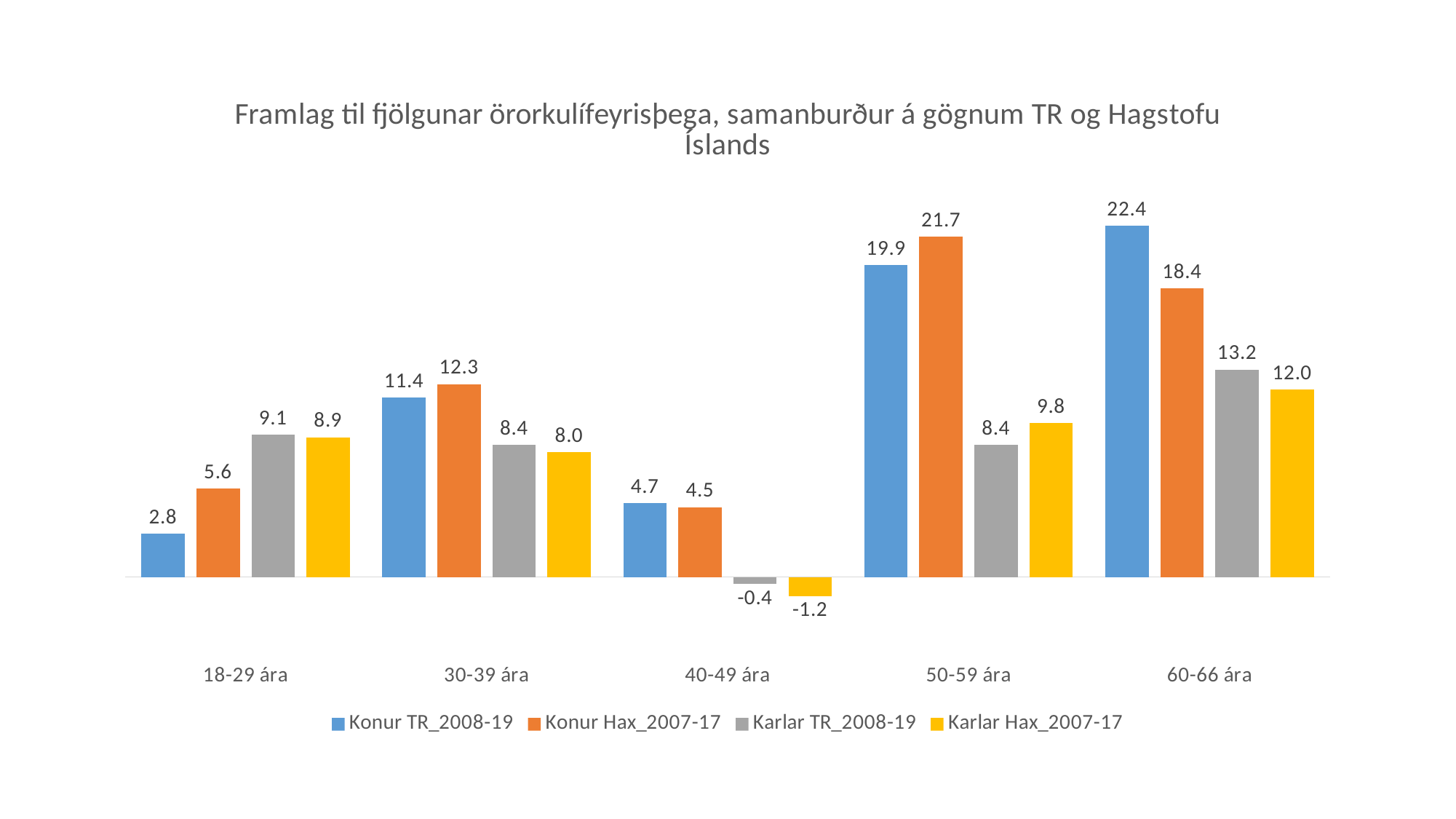
Which is larger in the 30-39 ára category: Konur TR_2008-19 or Konur Hax_2007-17? Konur Hax_2007-17 What is the value for Karlar Hax_2007-17 in the 50-59 ára category? 9.8 How many series does the legend list? 4 What is the value for Karlar Hax_2007-17 in the 40-49 ára category? -1.2 What kind of chart is shown on the slide? Bar chart What is the value for Konur TR_2008-19 in the 18-29 ára category? 2.8 Which age category has the lowest value for Karlar TR_2008-19? 40-49 ára Which colour represents Karlar TR_2008-19 in the legend? Grey Which age category has the highest value for Konur TR_2008-19? 60-66 ára How many age categories are shown on the x axis? 5 What is the difference between Konur TR_2008-19 and Karlar TR_2008-19 in the 60-66 ára category? 9.2 What is the value for Konur Hax_2007-17 in the 50-59 ára category? 21.7